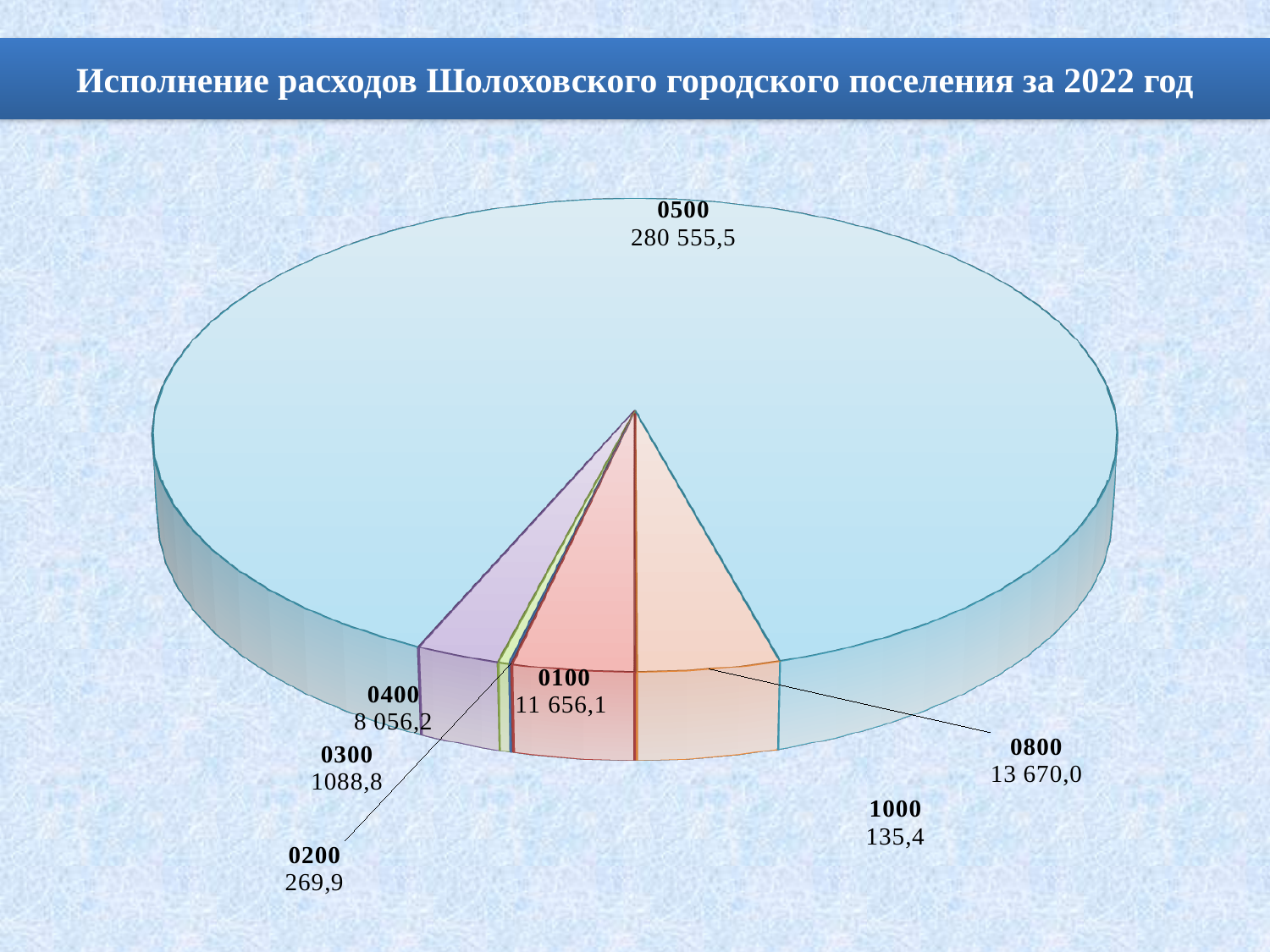
What value is shown for category 0100? 11 656,1 What value is shown for category 0800? 13 670,0 What value is shown for category 0500? 280 555,5 What value is shown for category 0300? 1088,8 What is the difference between the values for 0800 and 0100? 2 013,9 Which category has the largest slice of the pie? 0500 What type of chart is shown on the slide? Pie chart Which is larger, the value for 0200 or the value for 1000? 0200 What is the title of the slide? Исполнение расходов Шолоховского городского поселения за 2022 год What is the difference between the values for 0400 and 0300? 6 967,4